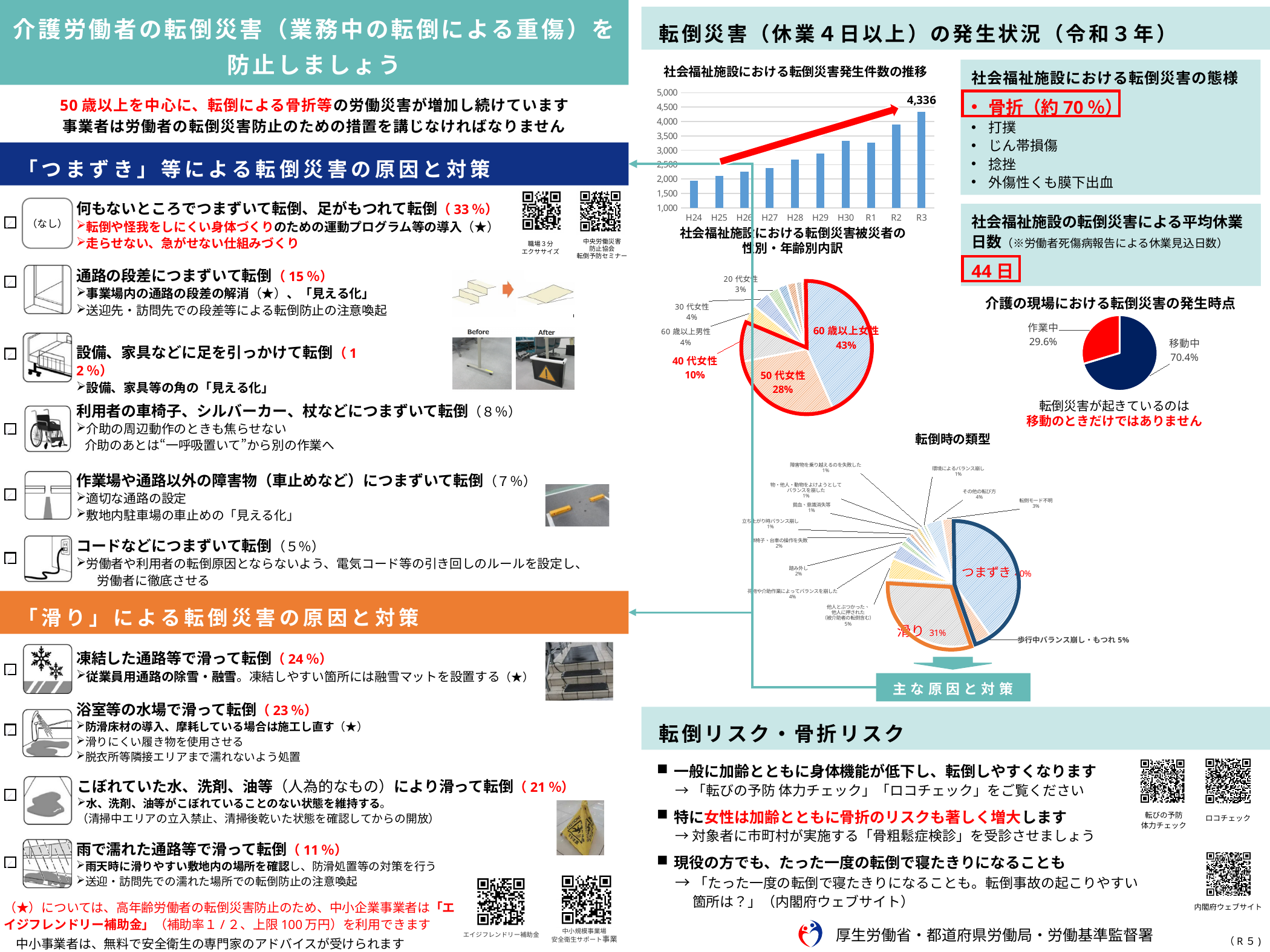
In the bar chart titled 社会福祉施設における転倒災害発生件数の推移, how many years are shown on the x axis? 10 In the bar chart titled 社会福祉施設における転倒災害発生件数の推移, which year has the lowest bar? H24 In the pie chart titled 社会福祉施設における転倒災害被災者の性別・年齢別内訳, what share is labelled for 50代女性? 28% In the bar chart titled 社会福祉施設における転倒災害発生件数の推移, what value is labelled for R3? 4,336 In the bar chart titled 社会福祉施設における転倒災害発生件数の推移, is the value for H24 greater or less than 2,500? less In the pie chart titled 社会福祉施設における転倒災害被災者の性別・年齢別内訳, what is the difference between the shares for 60歳以上女性 and 40代女性? 33% In the bar chart titled 社会福祉施設における転倒災害発生件数の推移, do the values generally rise or fall from H24 to R3? rise What kind of chart is 社会福祉施設における転倒災害発生件数の推移? bar chart In the pie chart titled 社会福祉施設における転倒災害被災者の性別・年齢別内訳, what share is labelled for 60歳以上女性? 43% In the pie chart titled 介護の現場における転倒災害の発生時点, what share is labelled for 移動中? 70.4% In the bar chart titled 社会福祉施設における転倒災害発生件数の推移, which year has the highest bar? R3